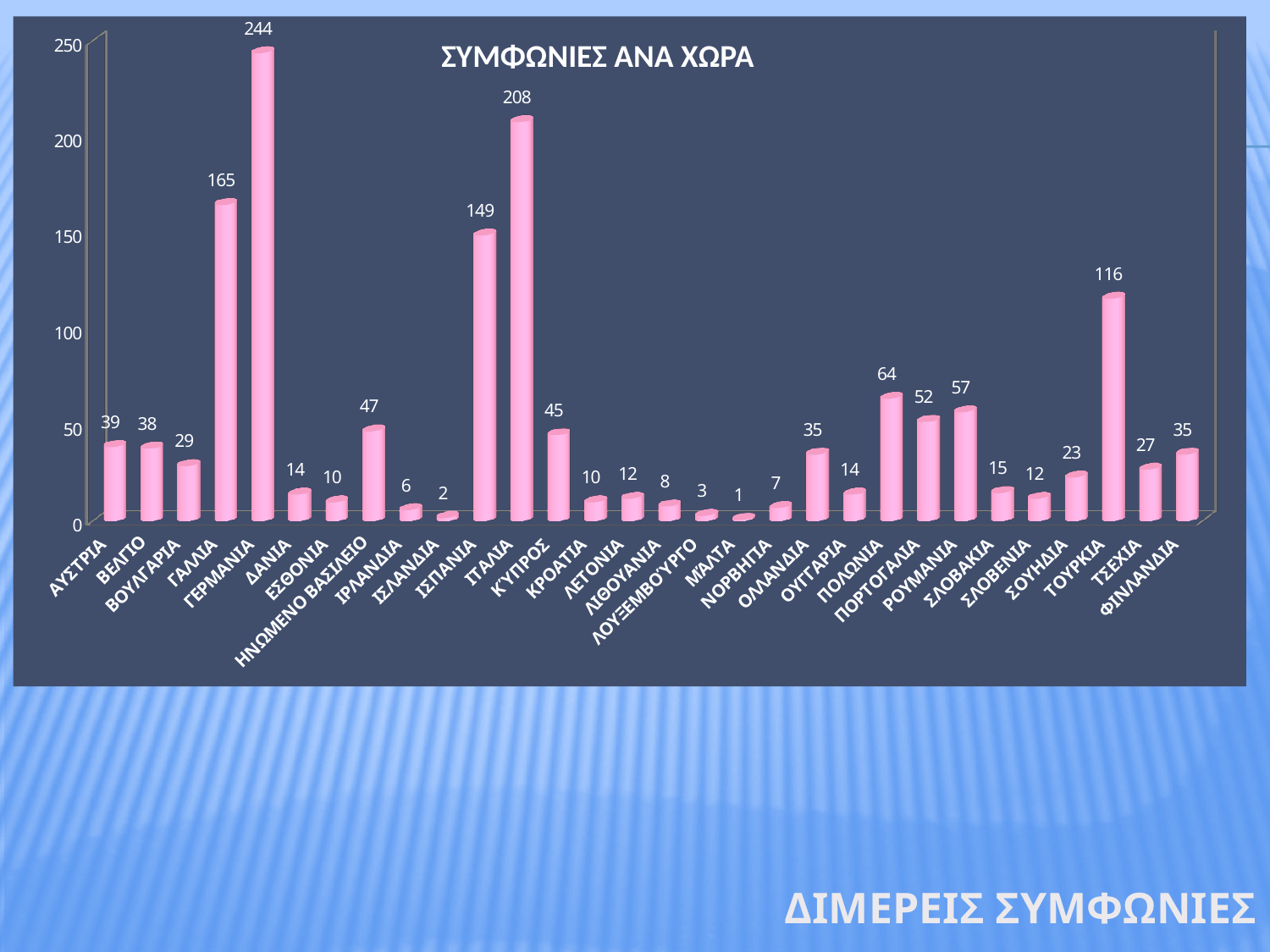
What is the value for ΓΕΡΜΑΝΙΑ? 244 Is the value for ΓΑΛΛΙΑ greater or less than 150? greater What is the difference between the values for ΓΕΡΜΑΝΙΑ and ΤΟΥΡΚΙΑ? 128 Which country has the highest value? ΓΕΡΜΑΝΙΑ What is the value for ΤΟΥΡΚΙΑ? 116 Which country has the lowest value? ΜΑΛΤΑ What is the value for ΗΝΩΜΕΝΟ ΒΑΣΙΛΕΙΟ? 47 How many countries are shown on the chart? 30 Which is larger, the value for ΠΟΛΩΝΙΑ or the value for ΡΟΥΜΑΝΙΑ? ΠΟΛΩΝΙΑ What is the title of the chart? ΣΥΜΦΩΝΙΕΣ ΑΝΑ ΧΩΡΑ What kind of chart is shown? bar chart What is the difference between the values for ΙΤΑΛΙΑ and ΙΣΠΑΝΙΑ? 59